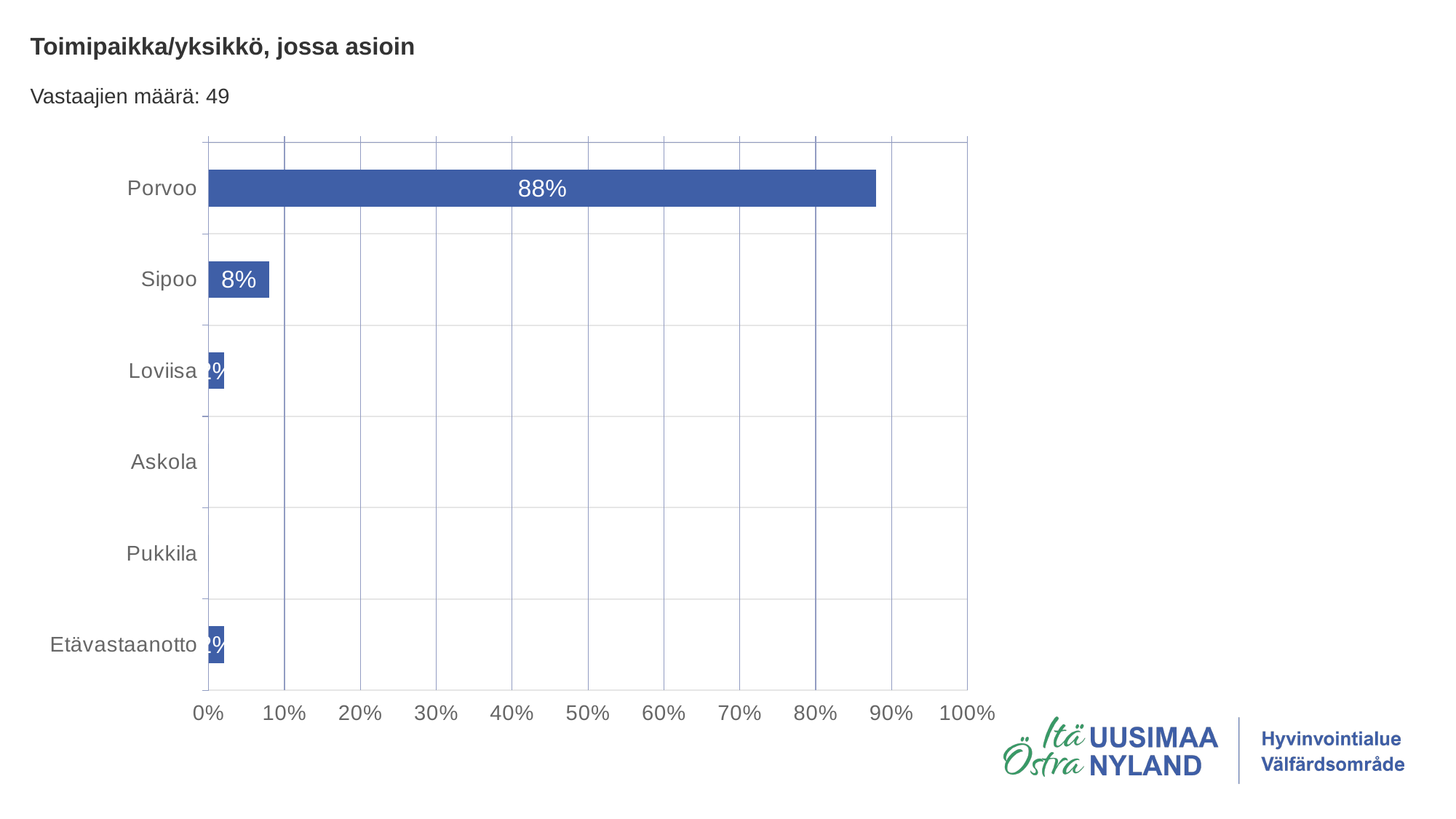
How many categories are shown on the chart? 6 What is the difference between the values for Porvoo and Sipoo? 80% Is the value for Sipoo greater or less than 10%? less Is the value for Porvoo greater or less than 80%? greater Which two categories have no visible bar? Askola and Pukkila Which category has the highest value? Porvoo What is the value for Porvoo? 88% Which is larger, the value for Sipoo or the value for Loviisa? Sipoo How many respondents (Vastaajien määrä) does the slide report? 49 What is the value for Sipoo? 8% What kind of chart is shown on the slide? bar chart What is the title of the chart? Toimipaikka/yksikkö, jossa asioin